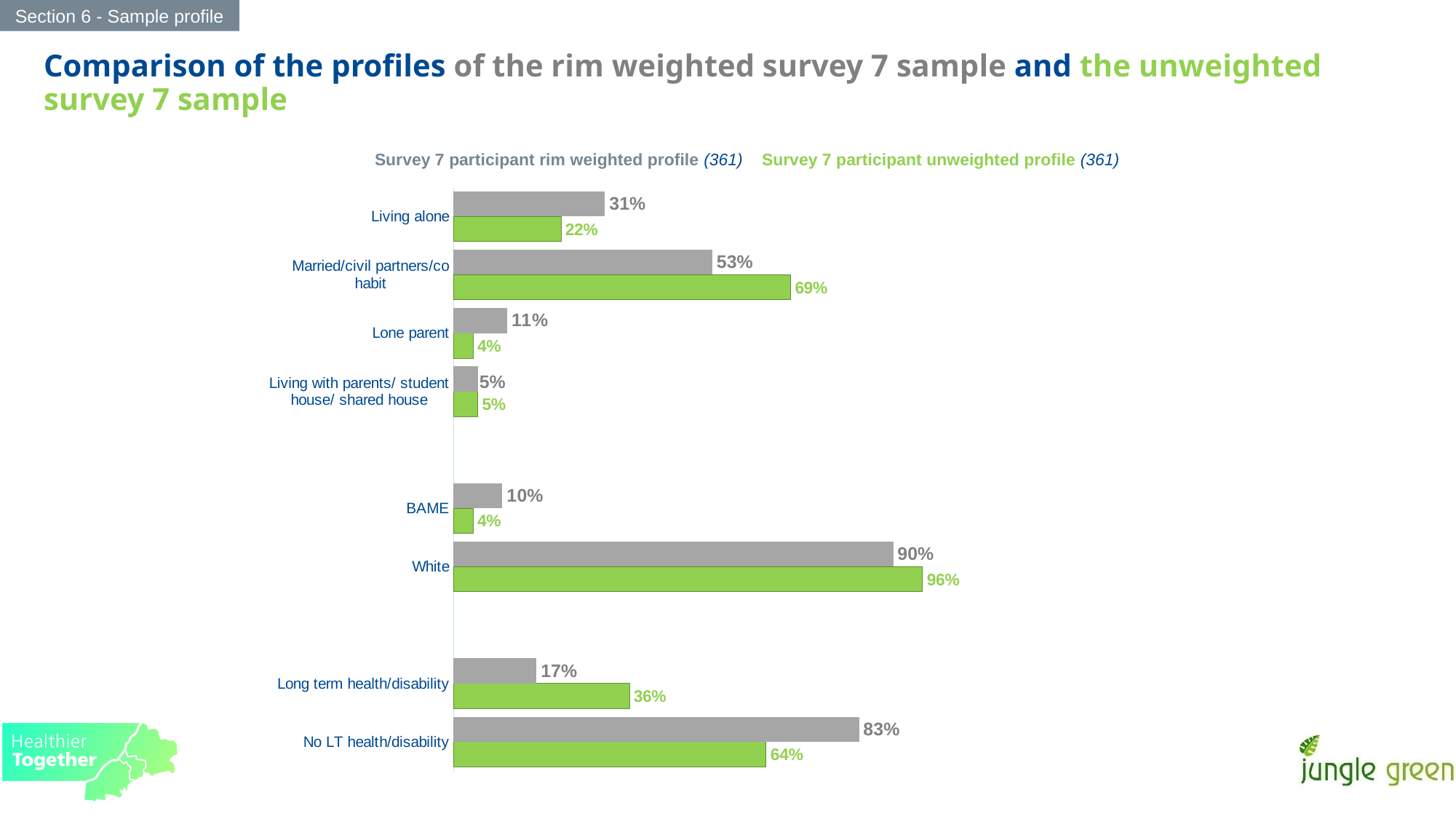
How many series does the legend list? 2 What is the rim weighted profile value for Living alone? 31% What is the unweighted profile value for Married/civil partners/co habit? 69% Which category has the lowest rim weighted profile value? Living with parents/ student house/ shared house What colour are the bars for the Survey 7 participant unweighted profile series? Green What is the rim weighted profile value for BAME? 10% Which is larger for Lone parent: the rim weighted profile value or the unweighted profile value? Rim weighted profile What is the unweighted profile value for Long term health/disability? 36% Which category has the highest unweighted profile value? White How many categories are shown on the chart? 8 What kind of chart is shown on the slide? Bar chart What is the difference between the rim weighted and unweighted profile values for No LT health/disability? 19%